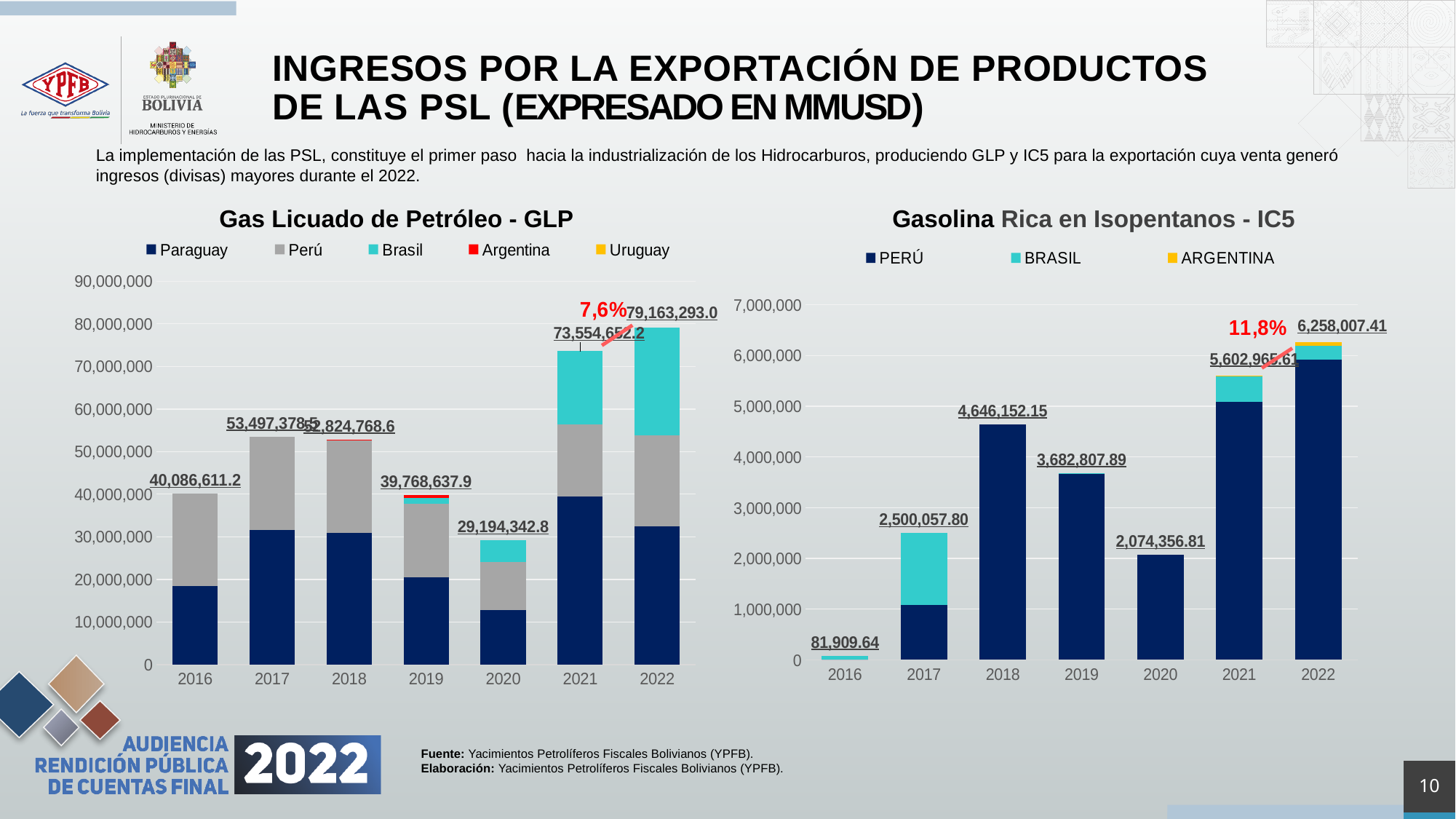
In the 'Gasolina Rica en Isopentanos - IC5' chart, how many years are shown on the x axis? 7 In the 'Gasolina Rica en Isopentanos - IC5' chart, which year has the highest total? 2022 In the 'Gas Licuado de Petróleo - GLP' chart, what is the difference between the 2017 total and the 2018 total? 672,609.9 In the 'Gas Licuado de Petróleo - GLP' chart, how many series does the legend list? 5 In the 'Gas Licuado de Petróleo - GLP' chart, which year has the highest total? 2022 What kind of chart is the 'Gasolina Rica en Isopentanos - IC5' chart? Stacked bar chart In the 'Gas Licuado de Petróleo - GLP' chart, what is the total value labeled for 2016? 40,086,611.2 In the 'Gas Licuado de Petróleo - GLP' chart, which year has the lowest total? 2020 In the 'Gas Licuado de Petróleo - GLP' chart, what is the total value labeled for 2022? 79,163,293.0 In the 'Gasolina Rica en Isopentanos - IC5' chart, what is the total value labeled for 2016? 81,909.64 In the 'Gasolina Rica en Isopentanos - IC5' chart, what is the total value labeled for 2018? 4,646,152.15 In the 'Gasolina Rica en Isopentanos - IC5' chart, is the 2019 total larger or the 2020 total? 2019